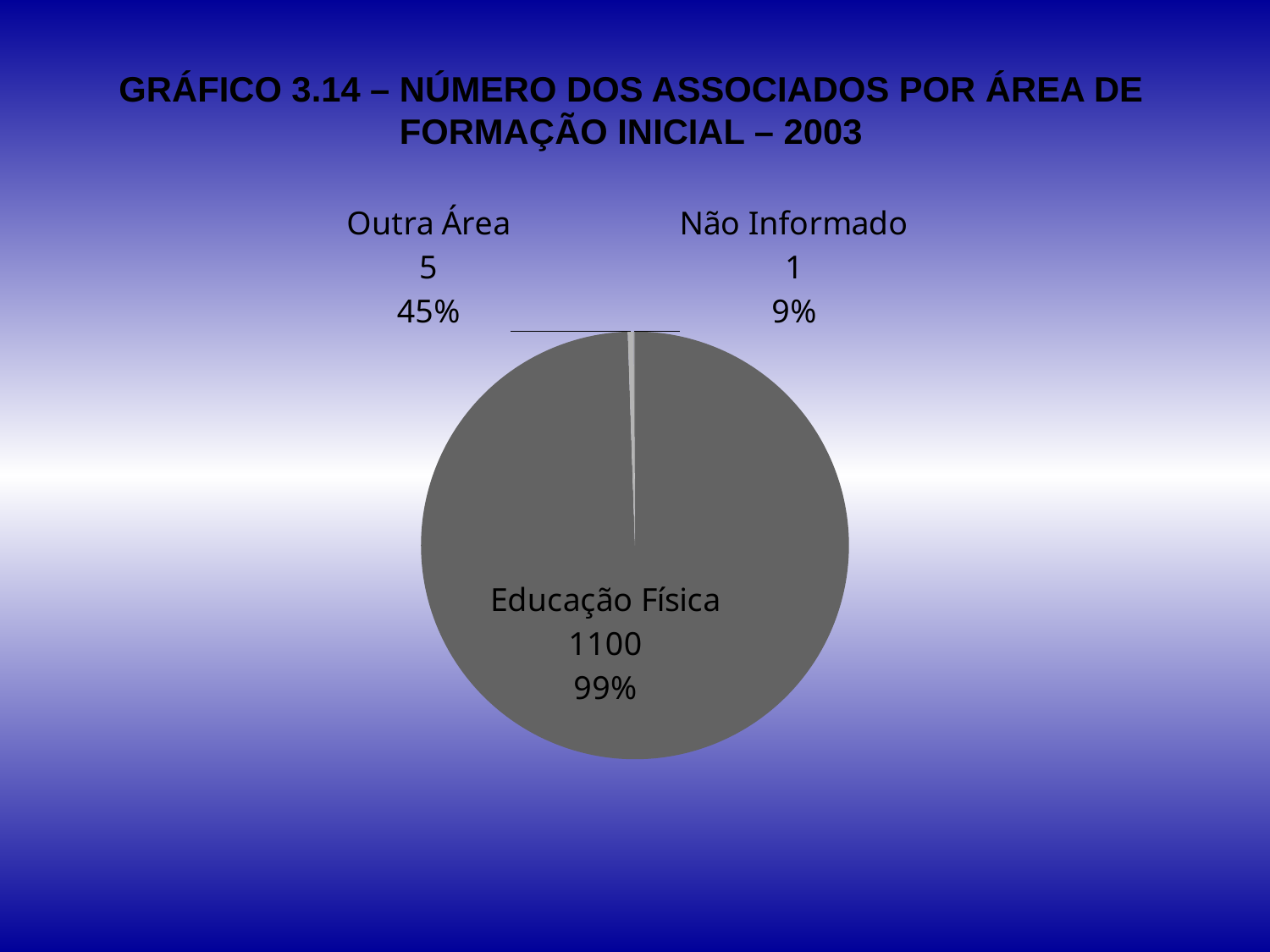
Which category has the largest number of associates? Educação Física What is the number of associates for Educação Física? 1100 What percentage label is shown for the Educação Física slice? 99% What is the difference between the values for Educação Física and Outra Área? 1095 How many slices does the pie chart have? 3 What is the number of associates for Não Informado? 1 What is the number of associates for Outra Área? 5 Which category has the smallest number of associates? Não Informado What kind of chart is shown on the slide? Pie chart What is the title of the chart? GRÁFICO 3.14 – NÚMERO DOS ASSOCIADOS POR ÁREA DE FORMAÇÃO INICIAL – 2003 What is the difference between the values for Outra Área and Não Informado? 4 Which is larger, the value for Outra Área or the value for Não Informado? Outra Área